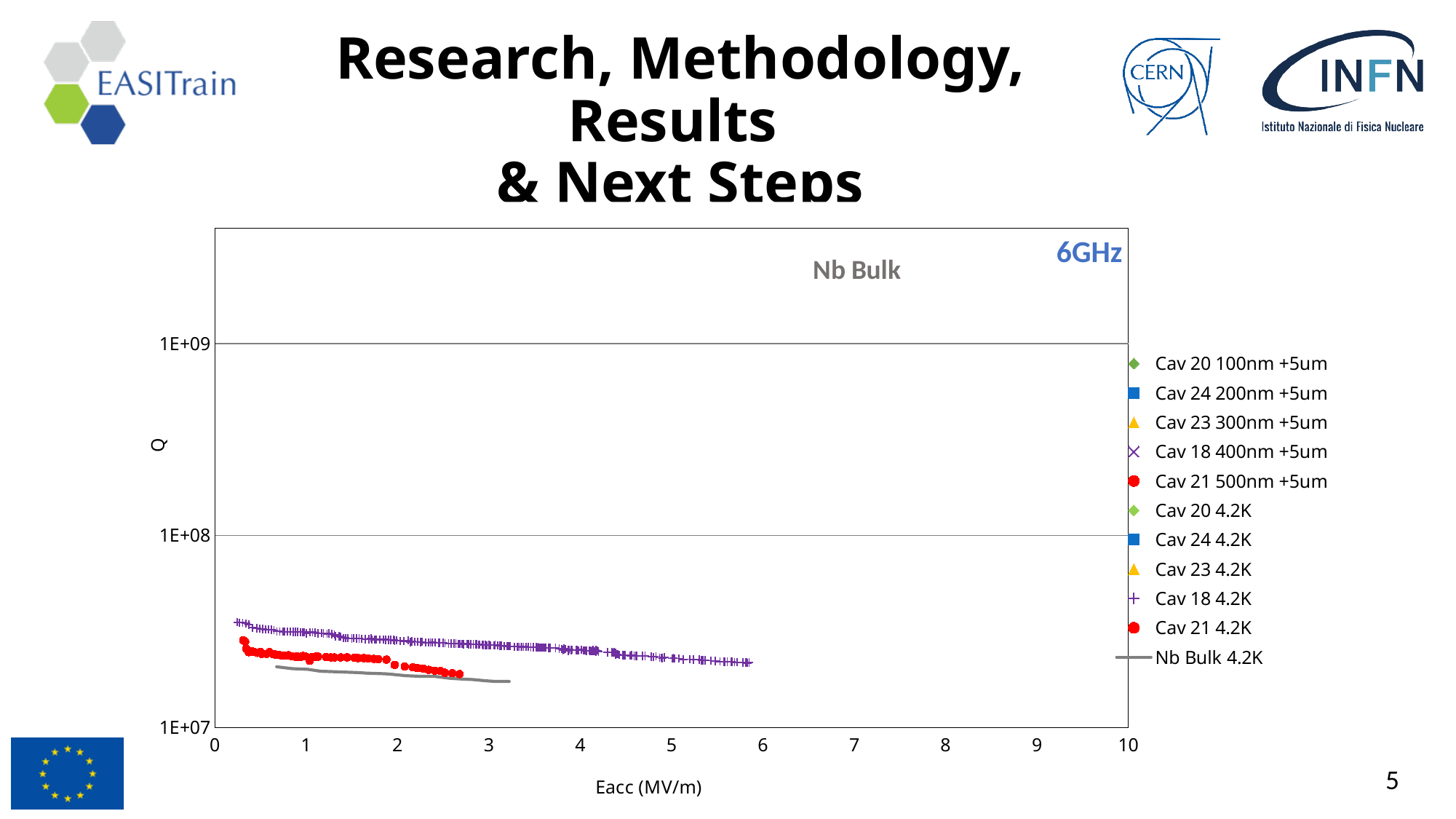
Do the Q values for Cav 18 4.2K rise or fall as Eacc increases? fall Which plotted series reaches the highest Eacc value? Cav 18 4.2K How many series does the legend list? 11 What is the label of the x axis? Eacc (MV/m) Are the Q values for Cav 21 4.2K greater or less than 1E+07? greater Which plotted series has the lowest Q values? Nb Bulk 4.2K Are the Q values for Cav 18 4.2K greater or less than 1E+08? less What kind of chart is shown on the slide? scatter chart At Eacc of 2 MV/m, which series has the higher Q: Cav 18 4.2K or Cav 21 4.2K? Cav 18 4.2K At Eacc of 2 MV/m, which series has the lower Q: Cav 21 4.2K or Nb Bulk 4.2K? Nb Bulk 4.2K What frequency is annotated in the top right corner of the chart? 6GHz Do the Q values for Cav 21 4.2K rise or fall as Eacc increases? fall